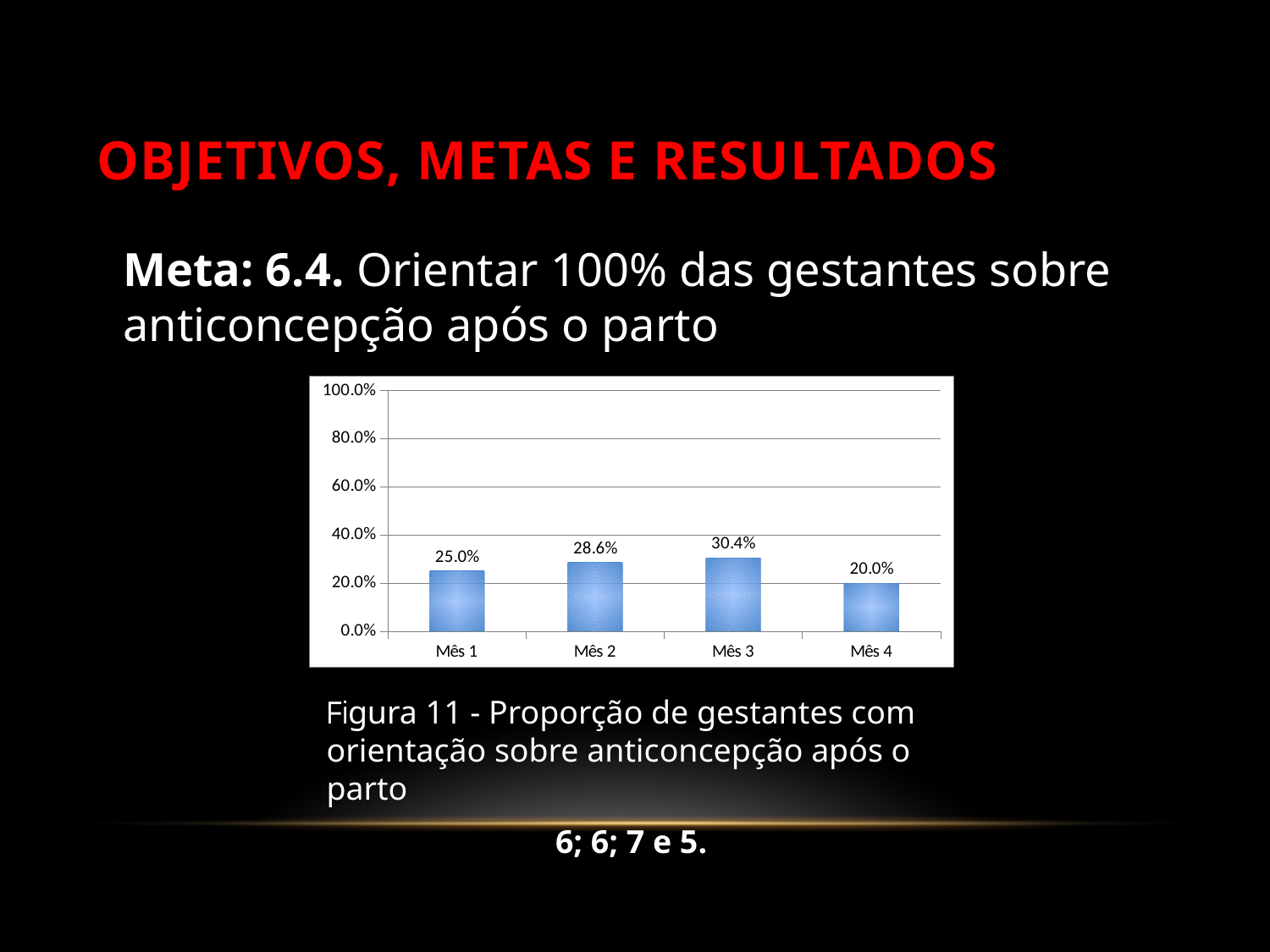
Which is larger, the value for Mês 2 or the value for Mês 4? Mês 2 How many months are shown on the x axis? 4 What is the difference between the values for Mês 2 and Mês 1? 3.6% Which month has the highest value? Mês 3 What is the value for Mês 4? 20.0% What kind of chart is shown on the slide? bar chart What is the value for Mês 3? 30.4% What is the value for Mês 1? 25.0% What is the figure caption below the chart? Figura 11 - Proporção de gestantes com orientação sobre anticoncepção após o parto Which month has the lowest value? Mês 4 What is the difference between the values for Mês 3 and Mês 4? 10.4% Is the value for Mês 3 greater or less than 40.0%? less